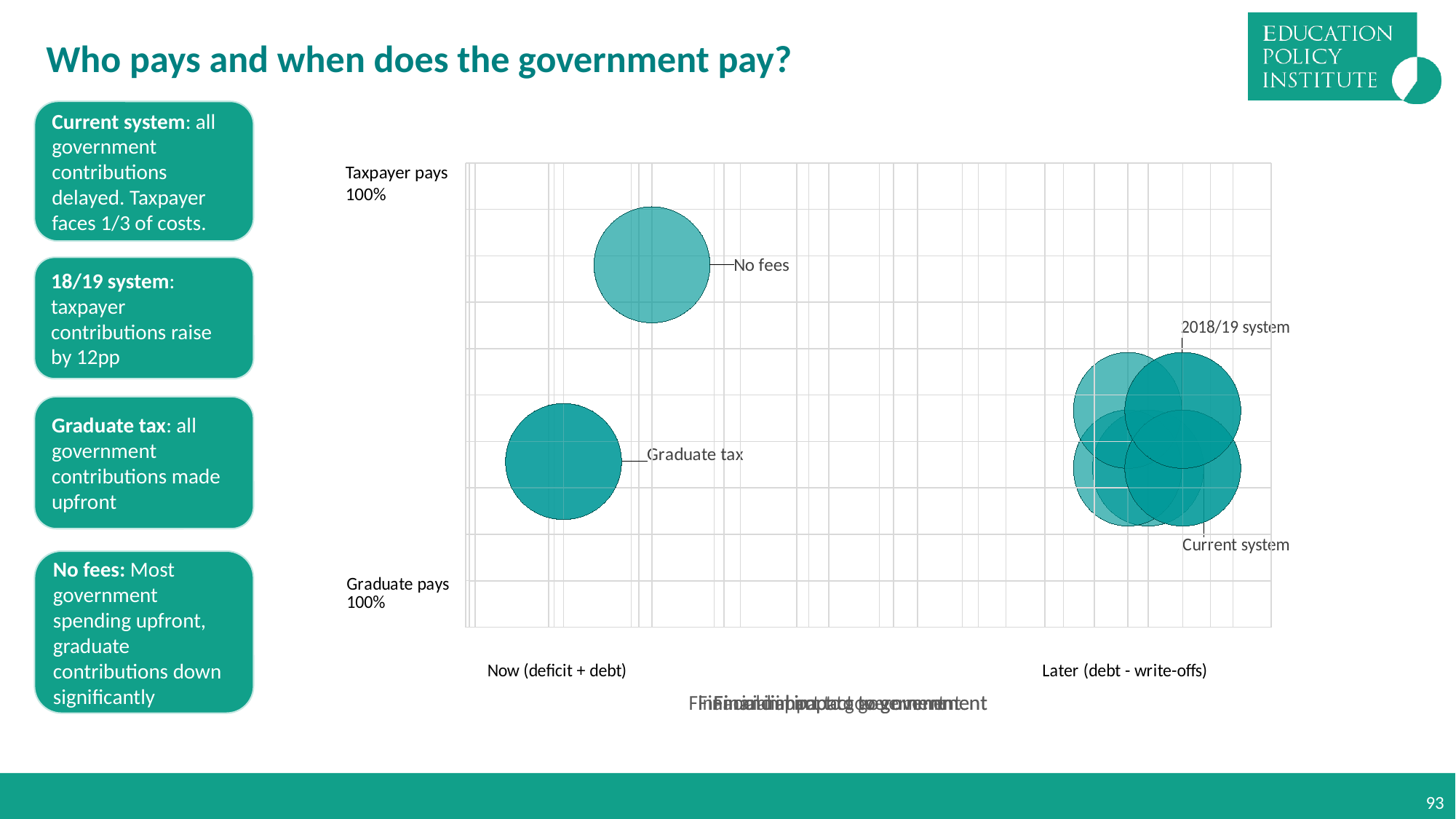
Which bubble is further toward the 'Later (debt - write-offs)' end of the horizontal axis, 'Graduate tax' or 'Current system'? Current system What is the label at the top of the vertical axis? Taxpayer pays 100% What kind of chart is shown on the slide? bubble chart Which labelled bubble is positioned closest to the 'Taxpayer pays 100%' end of the vertical axis? No fees Which is positioned higher on the vertical axis, the 'No fees' bubble or the '2018/19 system' bubble? No fees Which labelled bubble is positioned furthest to the left on the chart? Graduate tax Which is positioned higher on the vertical axis, the 'No fees' bubble or the 'Graduate tax' bubble? No fees What is the label at the right end of the horizontal axis? Later (debt - write-offs)